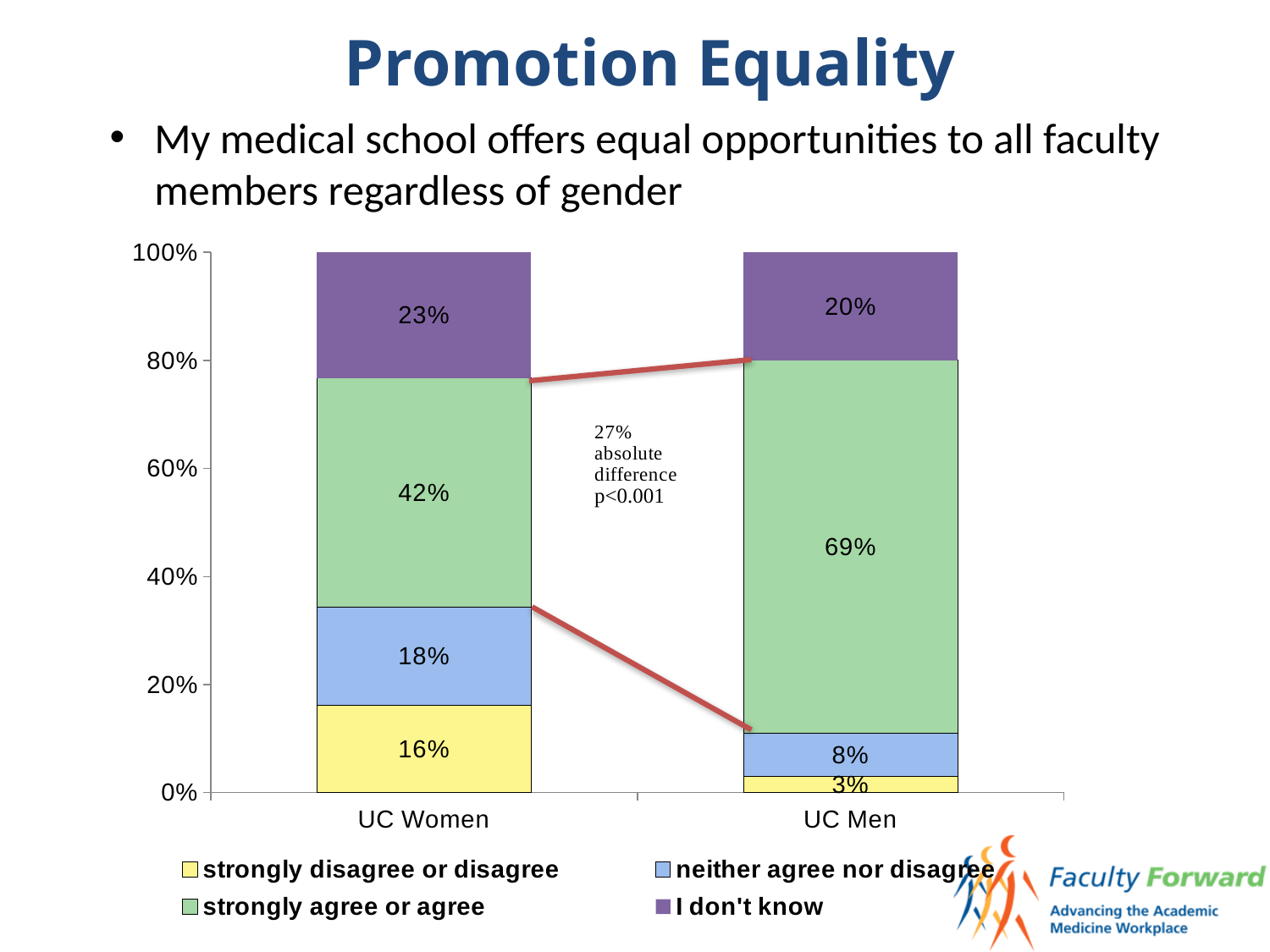
Which response category is the smallest for UC Men? strongly disagree or disagree How many groups are shown on the x axis? 2 What kind of chart is shown? stacked bar chart What percentage of UC Men answered 'I don't know'? 20% What percentage of UC Women strongly disagree or disagree? 16% What is the difference between the 'strongly agree or agree' percentages for UC Men and UC Women? 27% Which response category is the largest for UC Men? strongly agree or agree What percentage of UC Men strongly agree or agree? 69% What percentage of UC Men neither agree nor disagree? 8% How many series does the legend list? 4 What percentage of UC Women strongly agree or agree? 42% Which group has a larger 'neither agree nor disagree' share, UC Women or UC Men? UC Women